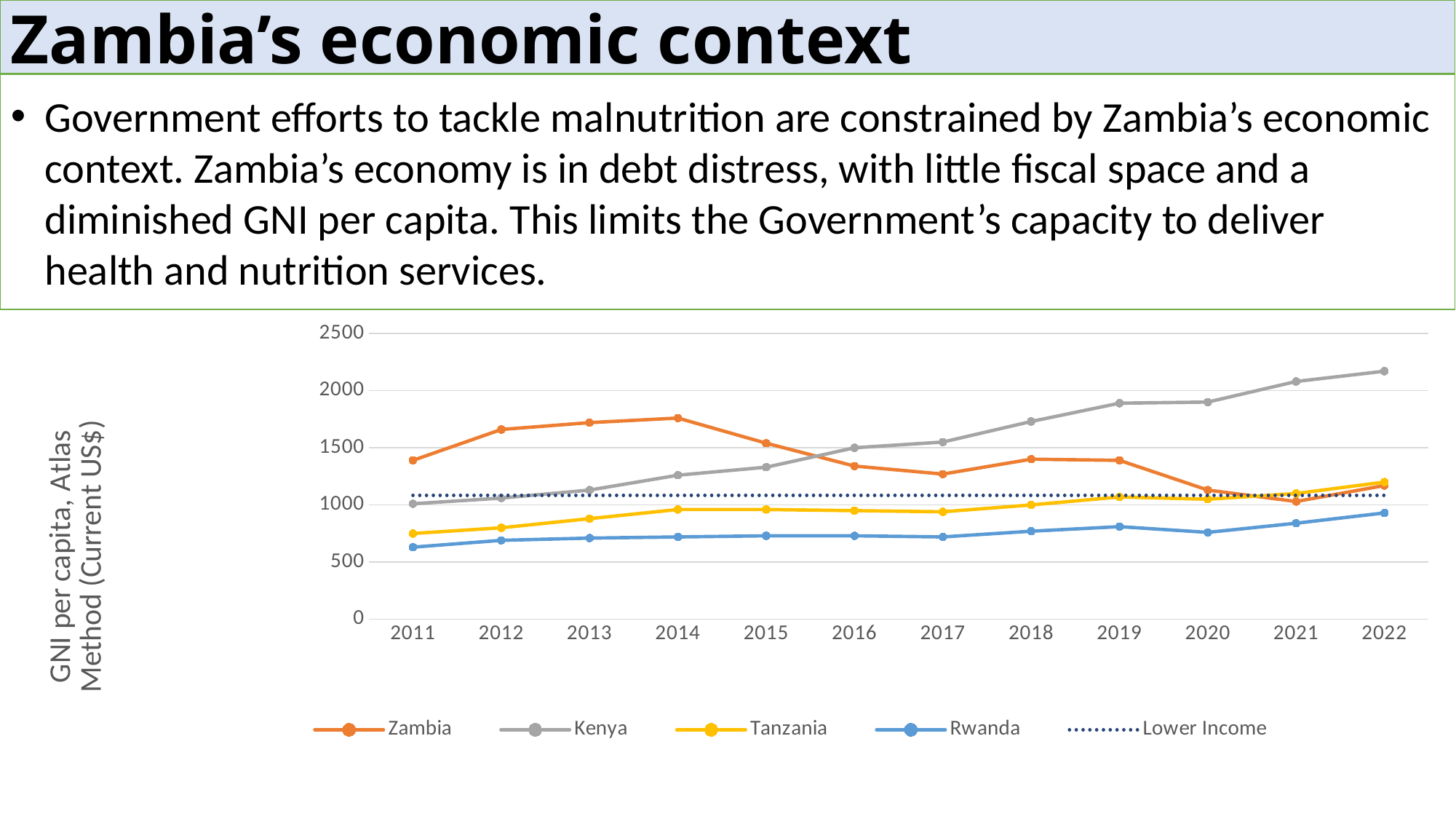
Is the value for Rwanda in 2022 greater or less than 1000? less Which country has the highest GNI per capita in 2022? Kenya Which country has the lowest GNI per capita in 2011? Rwanda How many years are plotted along the x axis? 12 How many series does the legend list? 5 Is the value for Kenya in 2022 greater or less than 2000? greater What is the label on the y axis? GNI per capita, Atlas Method (Current US$) Does the Kenya line rise or fall from 2011 to 2022? rise What kind of chart is shown on the slide? line chart Is the value for Zambia in 2014 greater or less than 1500? greater In 2012, which is larger: the value for Zambia or the value for Kenya? Zambia